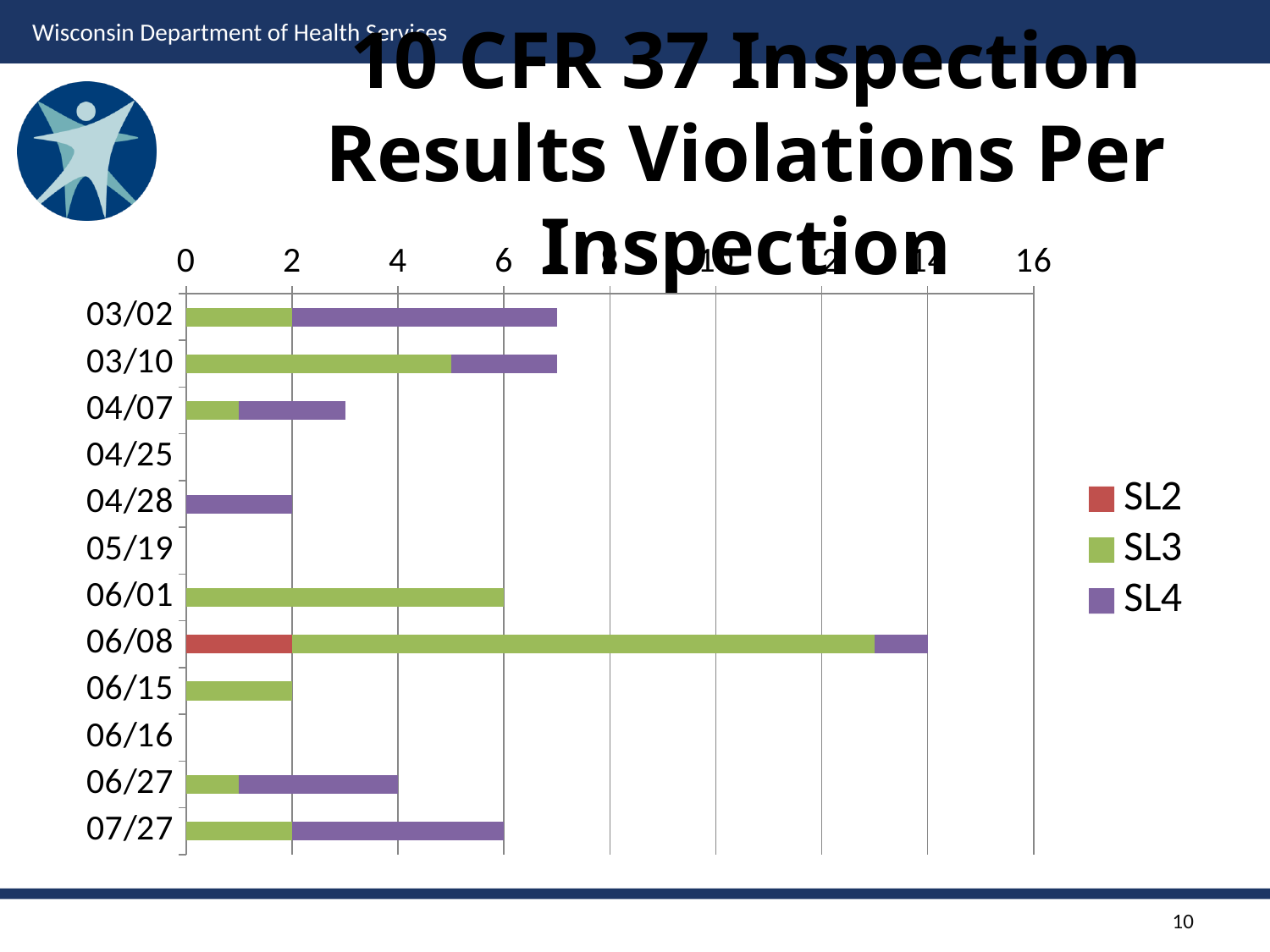
What is the SL3 value for 06/01? 6 What is the SL2 value for 06/08? 2 How many series does the legend list? 3 What kind of chart is shown on the slide? bar chart What is the SL4 value for 04/28? 2 Is the total value for 03/02 greater or less than 6? greater Which inspection date has the longest total bar? 06/08 How many inspection dates are shown on the vertical axis? 12 Which has the larger total bar, 03/02 or 04/07? 03/02 What is the difference between the total bar for 06/08 and the total bar for 07/27? 8 What is the total of the stacked bar for 07/27? 6 What is the total of the stacked bar for 06/08? 14